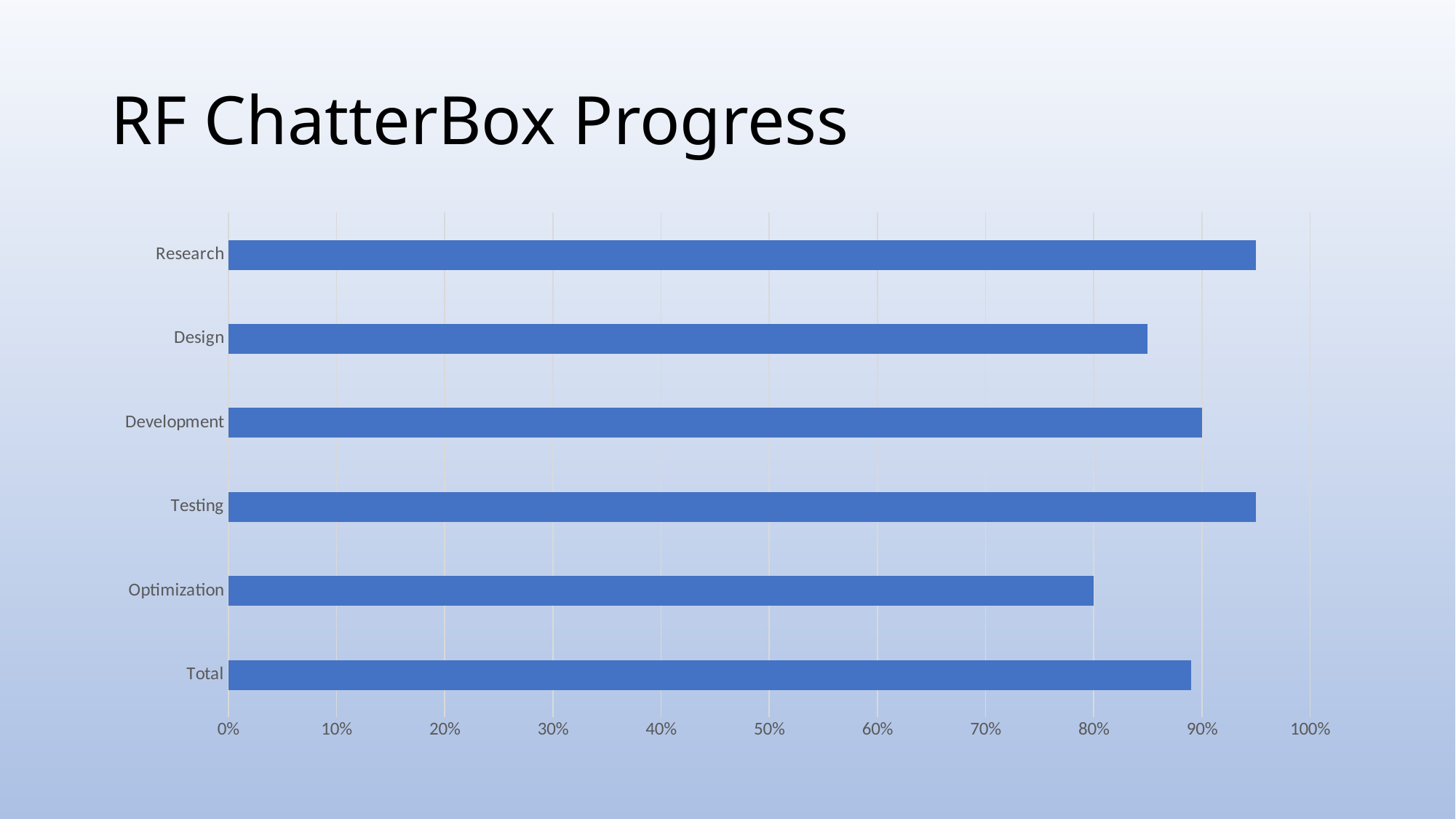
What kind of chart is shown on the slide? Bar chart Which is larger, the value for Design or the value for Development? Development How many categories are plotted in the chart? 6 Is the value for Design greater or less than 90%? less What is the title of the slide containing the chart? RF ChatterBox Progress Is the value for Total greater or less than 80%? greater Which category has the lowest value? Optimization Is the value for Research greater or less than 90%? greater What colour are the bars in the chart? Blue What is the value for Optimization? 80% Which is larger, the value for Research or the value for Design? Research What is the value for Development? 90%